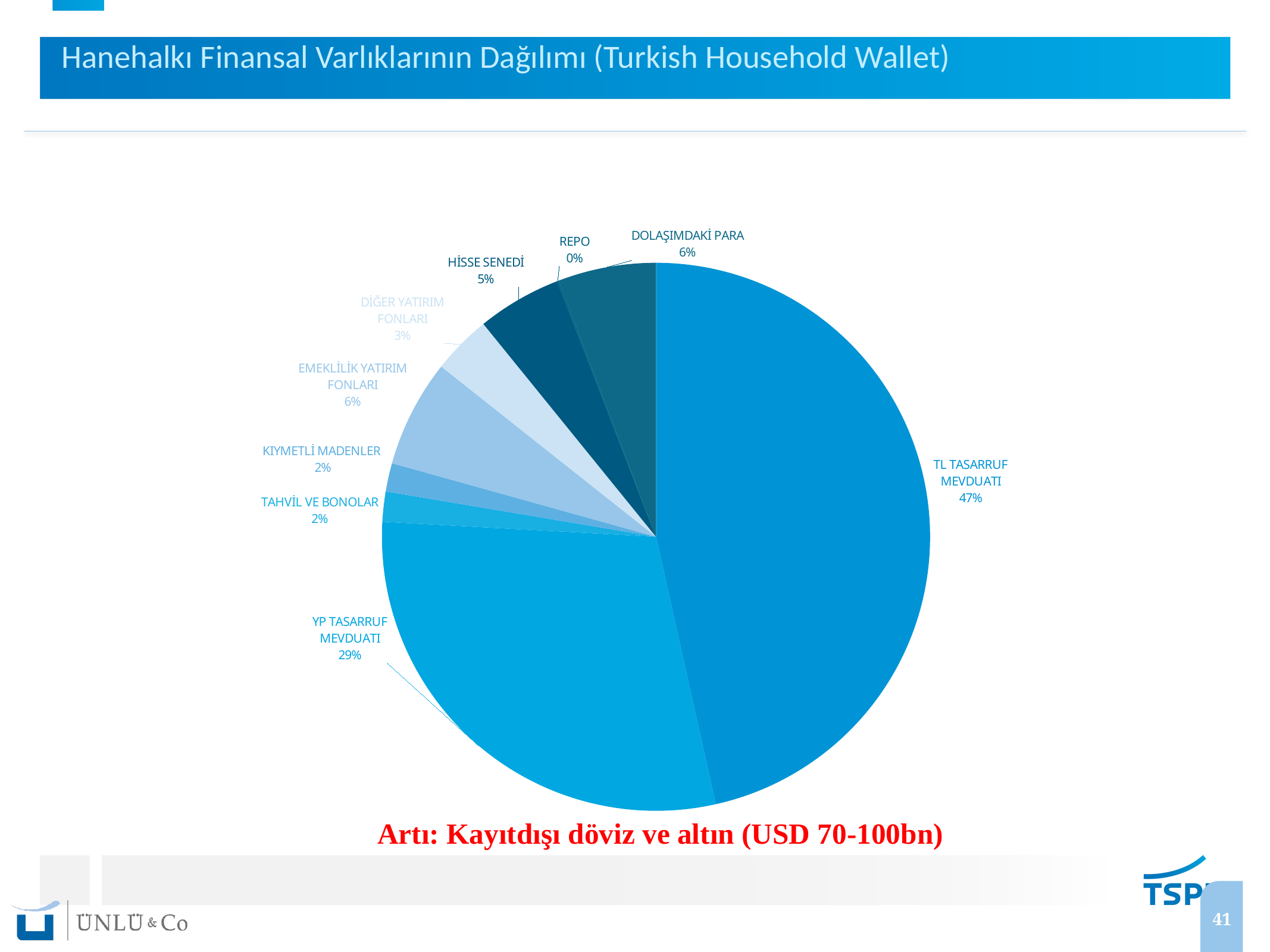
What is the value shown for HİSSE SENEDİ? 5% What share of the pie does TL TASARRUF MEVDUATI hold? 47% Which is larger, DOLAŞIMDAKİ PARA or HİSSE SENEDİ? DOLAŞIMDAKİ PARA Which category has the largest slice of the pie? TL TASARRUF MEVDUATI What kind of chart is shown on the slide? Pie chart What is the value shown for REPO? 0% What is the difference in percentage points between TL TASARRUF MEVDUATI and YP TASARRUF MEVDUATI? 18 How many categories are shown in the pie chart? 9 What is the value shown for EMEKLİLİK YATIRIM FONLARI? 6% What is the value shown for DİĞER YATIRIM FONLARI? 3% What share of the pie does YP TASARRUF MEVDUATI hold? 29% Which category has the smallest slice of the pie? REPO